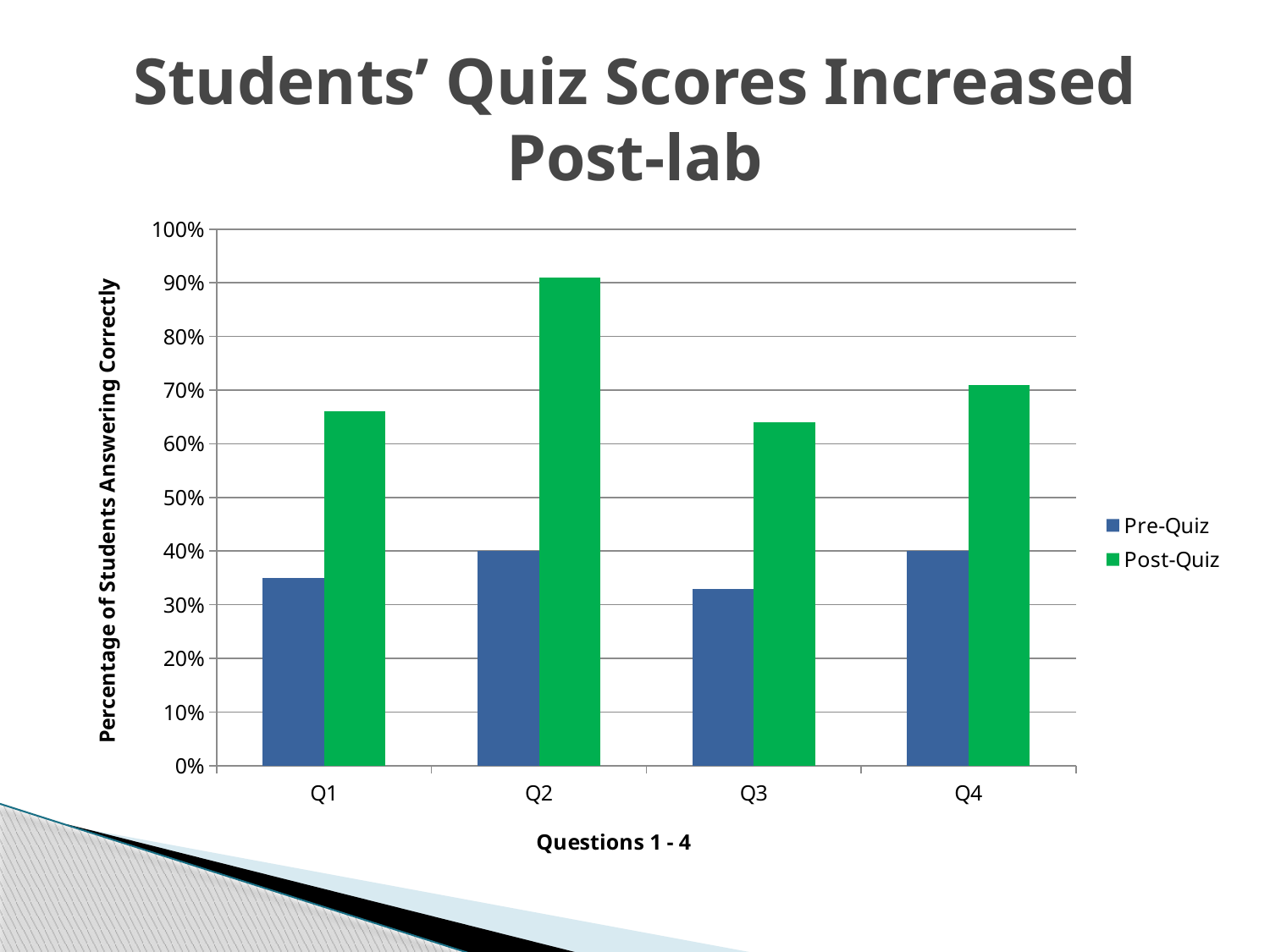
Which question has the highest Post-Quiz value? Q2 What is the Pre-Quiz value for Q4? 40% Is the Post-Quiz value for Q1 greater or less than 60%? greater What is the Pre-Quiz value for Q2? 40% Is the Pre-Quiz value for Q3 greater or less than 30%? greater What kind of chart is shown on the slide? bar chart Is the Post-Quiz value for Q2 greater or less than 80%? greater How many series does the legend list? 2 How many question categories are shown on the x axis? 4 Which is larger for Q1, the Pre-Quiz value or the Post-Quiz value? Post-Quiz What is the title of the y axis? Percentage of Students Answering Correctly Which is larger, the Post-Quiz value for Q2 or the Post-Quiz value for Q4? Q2